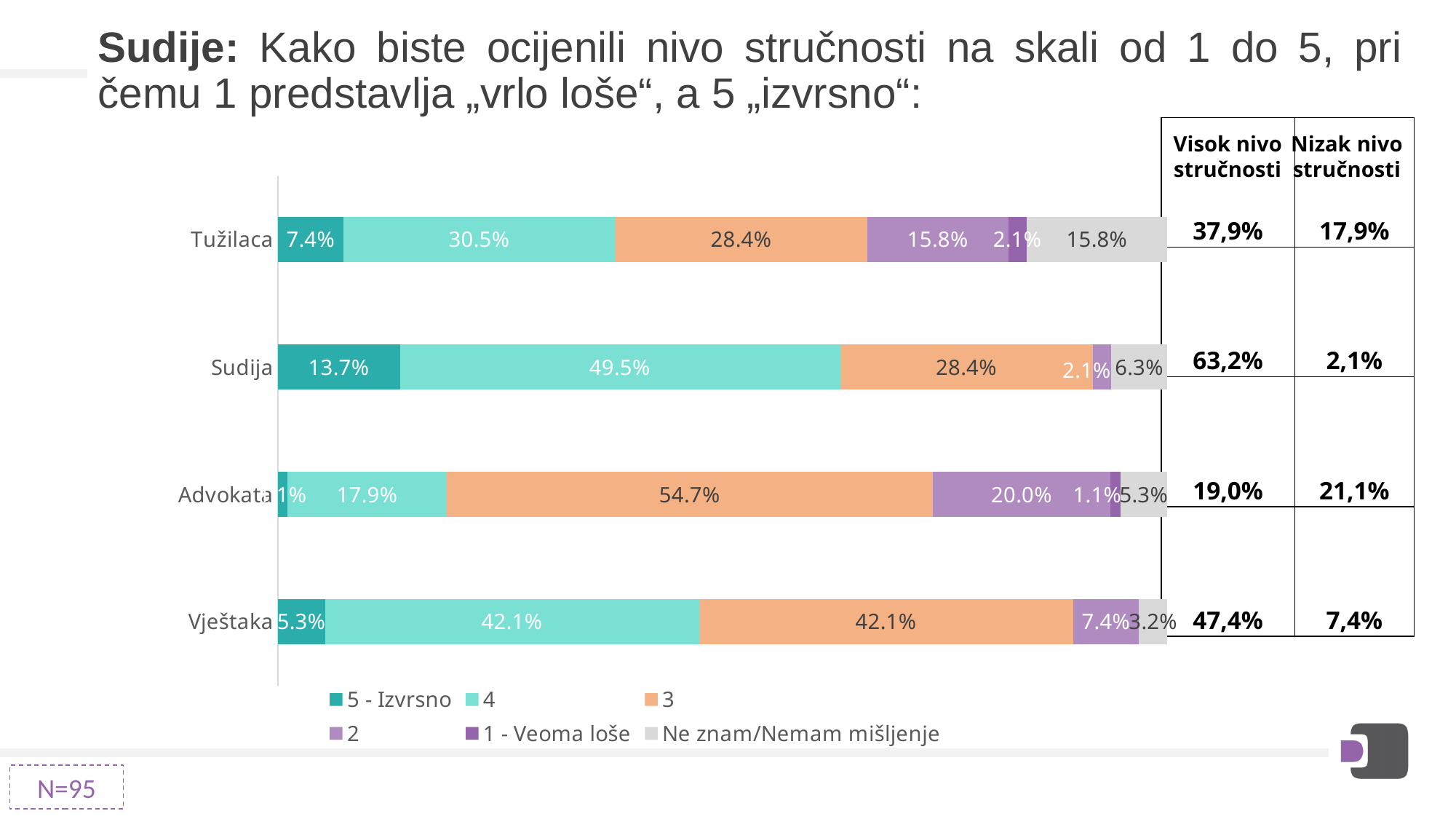
Which category has the highest value for the '5 - Izvrsno' series? Sudija What is the value of the 'Ne znam/Nemam mišljenje' series for Vještaka? 3.2% How many series does the legend list? 6 How many categories are plotted on the chart? 4 Which category has the lowest value for the '4' series? Advokata Which is larger: the '3' series value for Vještaka or for Tužilaca? Vještaka What is the value of the '5 - Izvrsno' series for Tužilaca? 7.4% What is the difference between the '2' series values for Advokata and Tužilaca? 4.2% What is the value of the '3' series for Advokata? 54.7% What kind of chart is shown on the slide? stacked bar chart According to the table next to the chart, what is the 'Visok nivo stručnosti' value for Sudija? 63,2% What is the value of the '4' series for Sudija? 49.5%